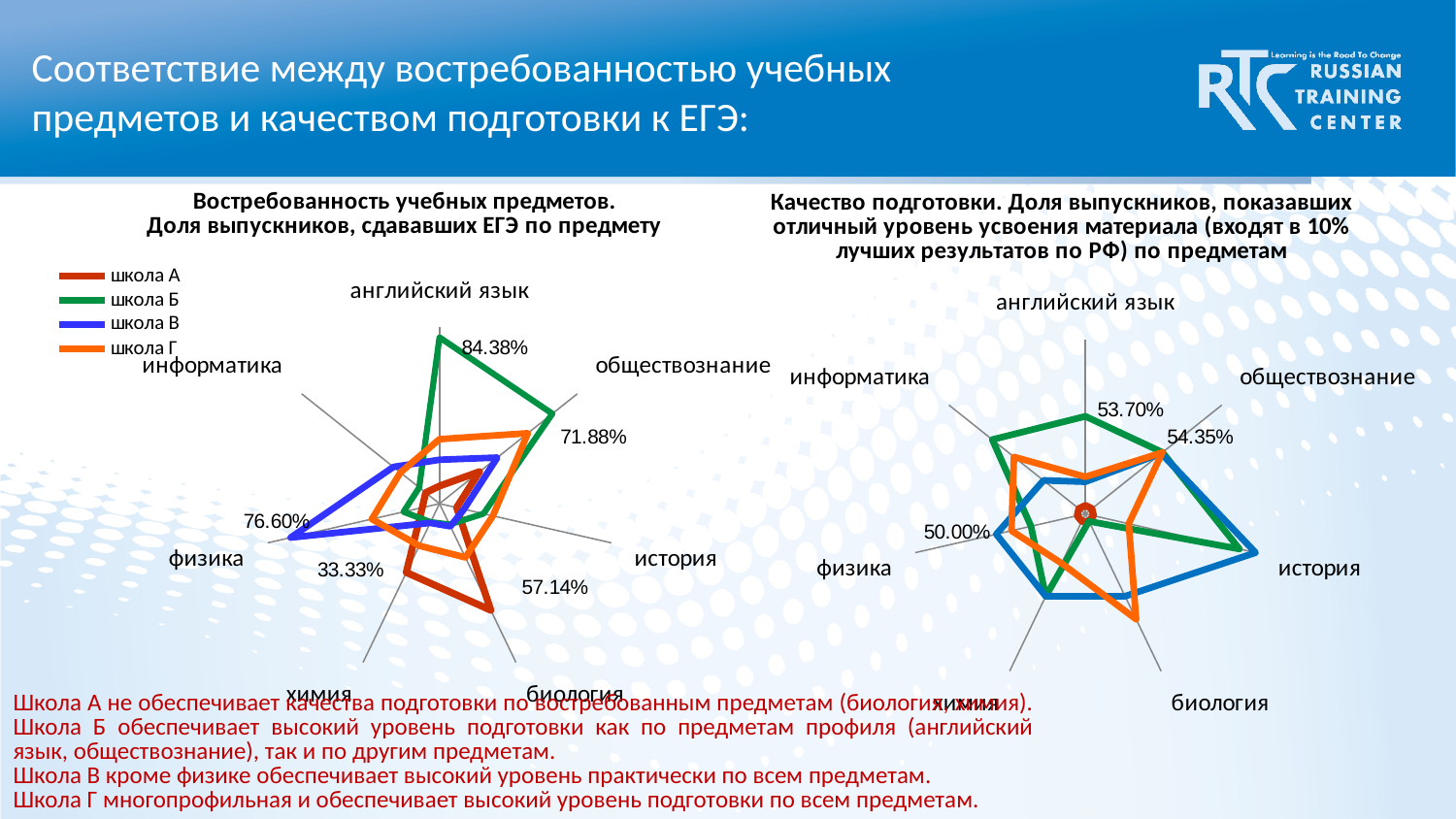
In the left chart (Востребованность учебных предметов), what is the value labelled for школа В on физика? 76.60% How many subject categories does the left chart (Востребованность учебных предметов) have? 7 In the left chart (Востребованность учебных предметов), which subject has the highest labelled value? английский язык In the left chart (Востребованность учебных предметов), what is the value labelled for школа А on биология? 57.14% In the right chart (Качество подготовки), what is the value labelled on английский язык? 53.70% How many series does the legend of the left chart (Востребованность учебных предметов) list? 4 In the left chart (Востребованность учебных предметов), what is the value labelled for школа Б on обществознание? 71.88% What kind of chart is used on the left side of the slide (Востребованность учебных предметов)? Radar chart In the left chart (Востребованность учебных предметов), what is the value labelled for школа Б on английский язык? 84.38% In the left chart (Востребованность учебных предметов), which school has the highest value on физика? школа В In the left chart (Востребованность учебных предметов), what is the difference between школа Б's values on английский язык and обществознание? 12.50% Which series is drawn in green in the left chart's legend? школа Б